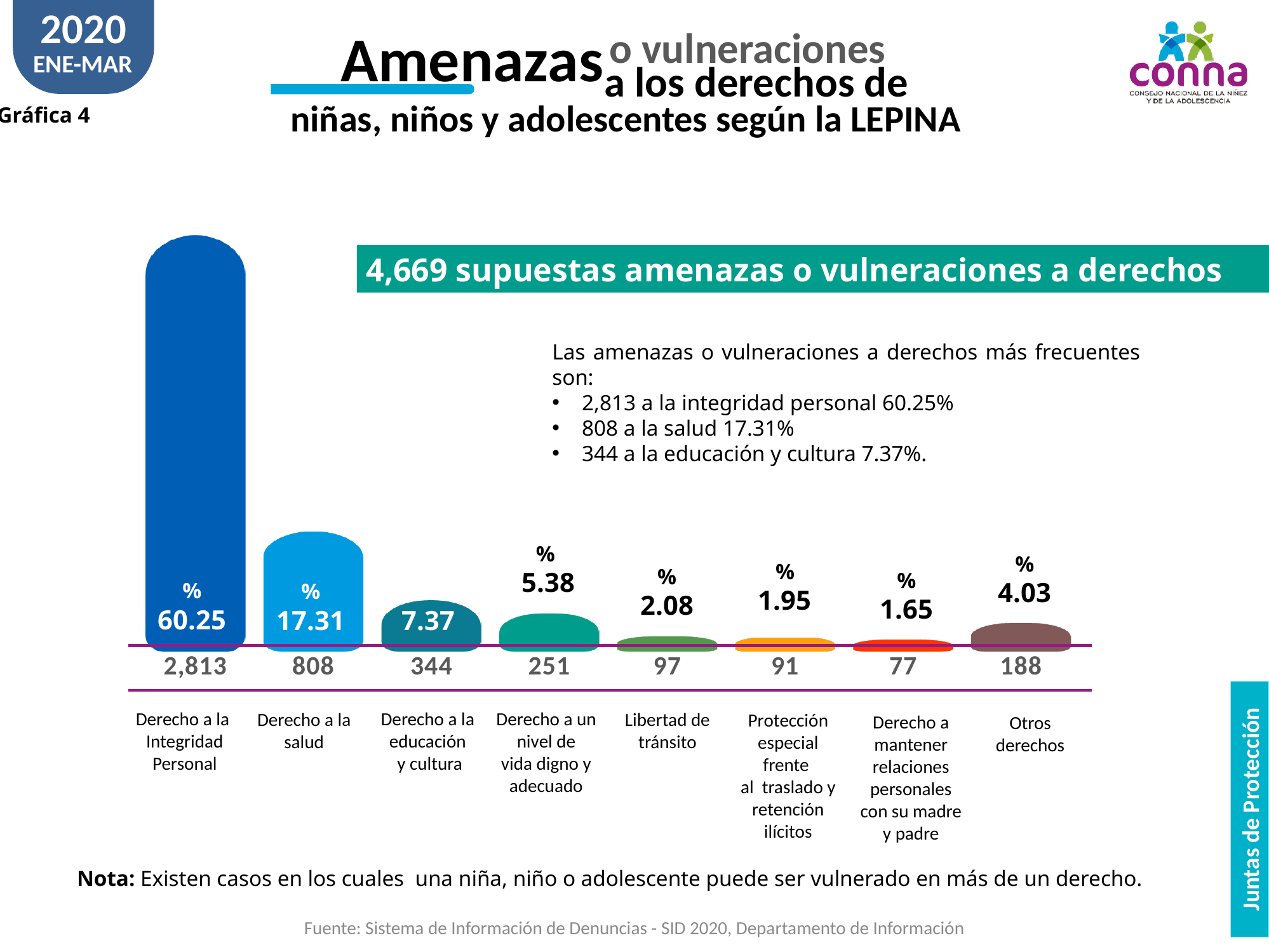
What is the difference in cases between Libertad de tránsito and Protección especial frente al traslado y retención ilícitos? 6 What percentage is shown for Derecho a la educación y cultura? 7.37% How many categories are shown in the chart? 8 What is the number of cases for Derecho a la salud? 808 What kind of chart is shown on the slide? Bar chart What is the number of cases for Libertad de tránsito? 97 Which has more cases, Otros derechos or Derecho a un nivel de vida digno y adecuado? Derecho a un nivel de vida digno y adecuado What is the difference in cases between Derecho a la Integridad Personal and Derecho a la salud? 2,005 Which category has the lowest number of cases? Derecho a mantener relaciones personales con su madre y padre Which category has the highest number of cases? Derecho a la Integridad Personal What is the total number of supposed threats or violations of rights stated on the slide? 4,669 What percentage is shown for Otros derechos? 4.03%